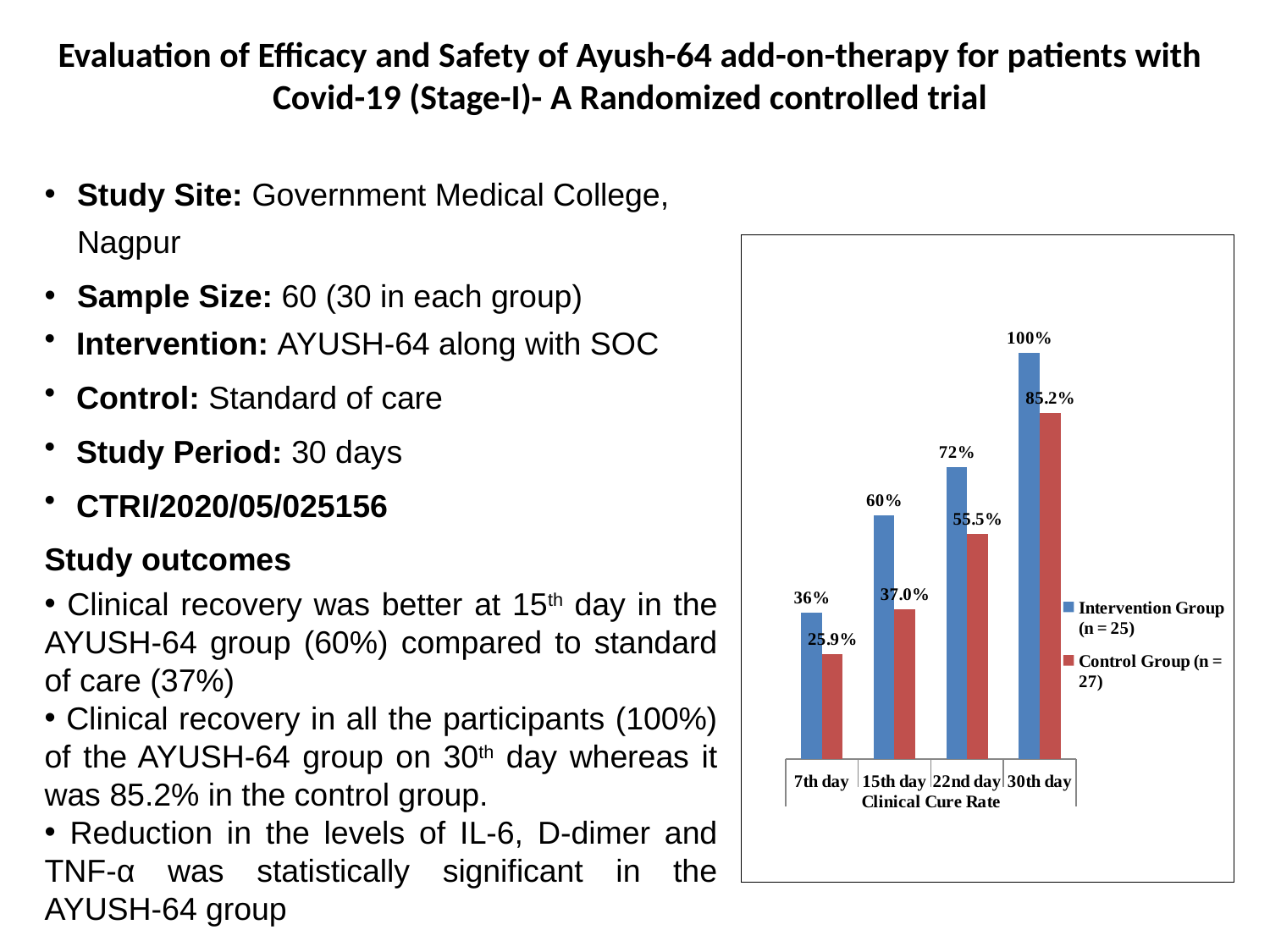
What kind of chart is shown on the slide? Bar chart Does the Control Group (n = 27) Clinical Cure Rate rise or fall from the 7th day to the 30th day? Rise On which day is the Control Group (n = 27) Clinical Cure Rate lowest? 7th day What is the Clinical Cure Rate for the Intervention Group (n = 25) on the 15th day? 60% How many time points (categories) are shown on the x axis of the chart? 4 What is the difference between the Intervention Group and Control Group Clinical Cure Rates on the 30th day? 14.8% How many series does the chart legend list? 2 What is the Clinical Cure Rate for the Control Group (n = 27) on the 30th day? 85.2% Which group has the higher Clinical Cure Rate on the 22nd day? Intervention Group (n = 25) What is the Clinical Cure Rate for the Control Group (n = 27) on the 7th day? 25.9% What is the Clinical Cure Rate for the Intervention Group (n = 25) on the 22nd day? 72% On which day is the Intervention Group (n = 25) Clinical Cure Rate highest? 30th day